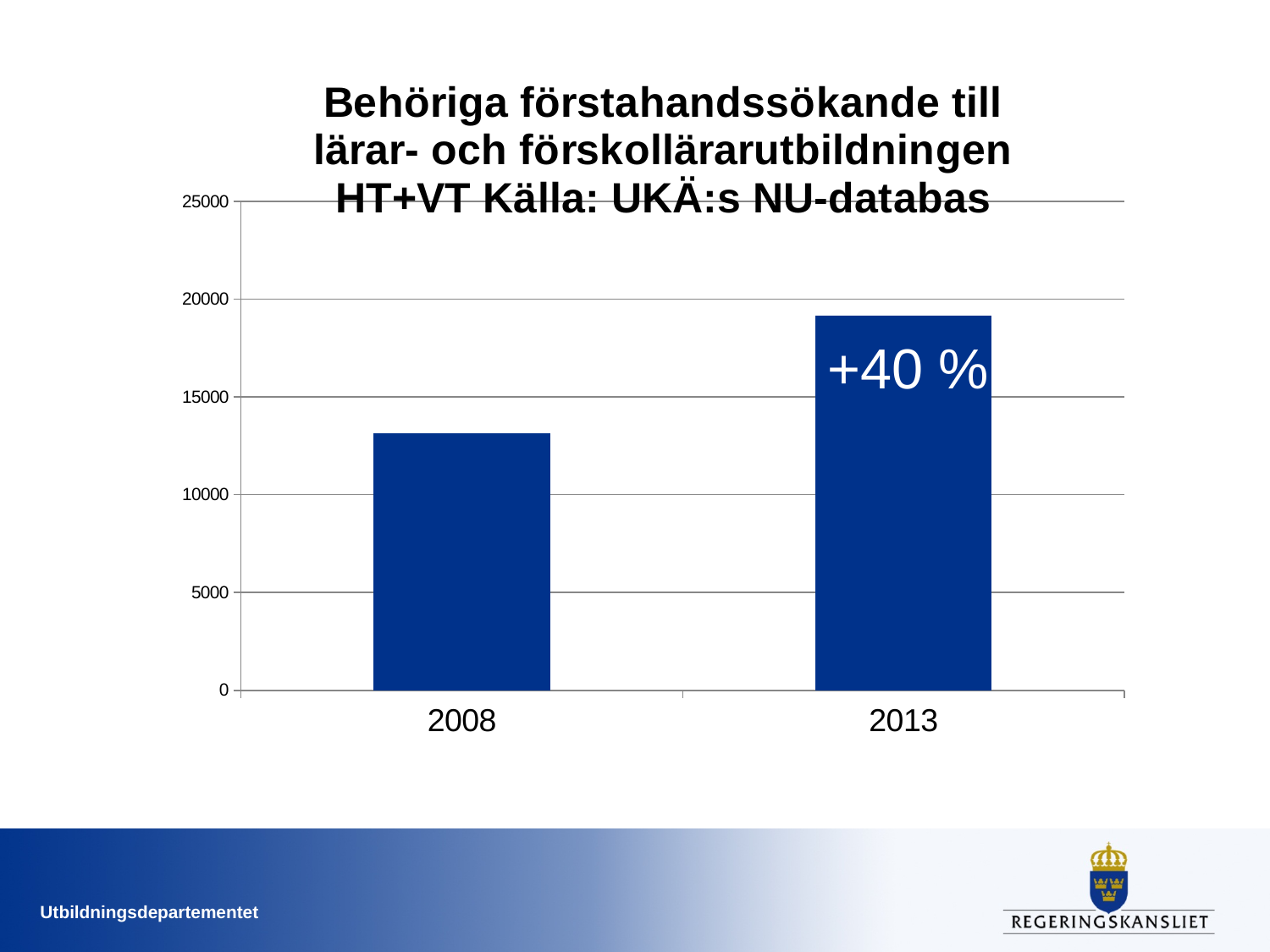
Which is larger, the value for 2008 or the value for 2013? 2013 Which year has the highest value in the chart? 2013 Is the value for 2013 greater or less than 15000? greater Is the value for 2008 greater or less than 15000? less What percentage change is printed on the 2013 bar? +40 % What is the highest value shown on the y axis of the chart? 25000 How many categories (years) are shown on the x axis of the chart? 2 Is the value for 2008 greater or less than 10000? greater Do the values rise or fall from 2008 to 2013? rise Which year has the lowest value in the chart? 2008 What kind of chart is shown on the slide? bar chart